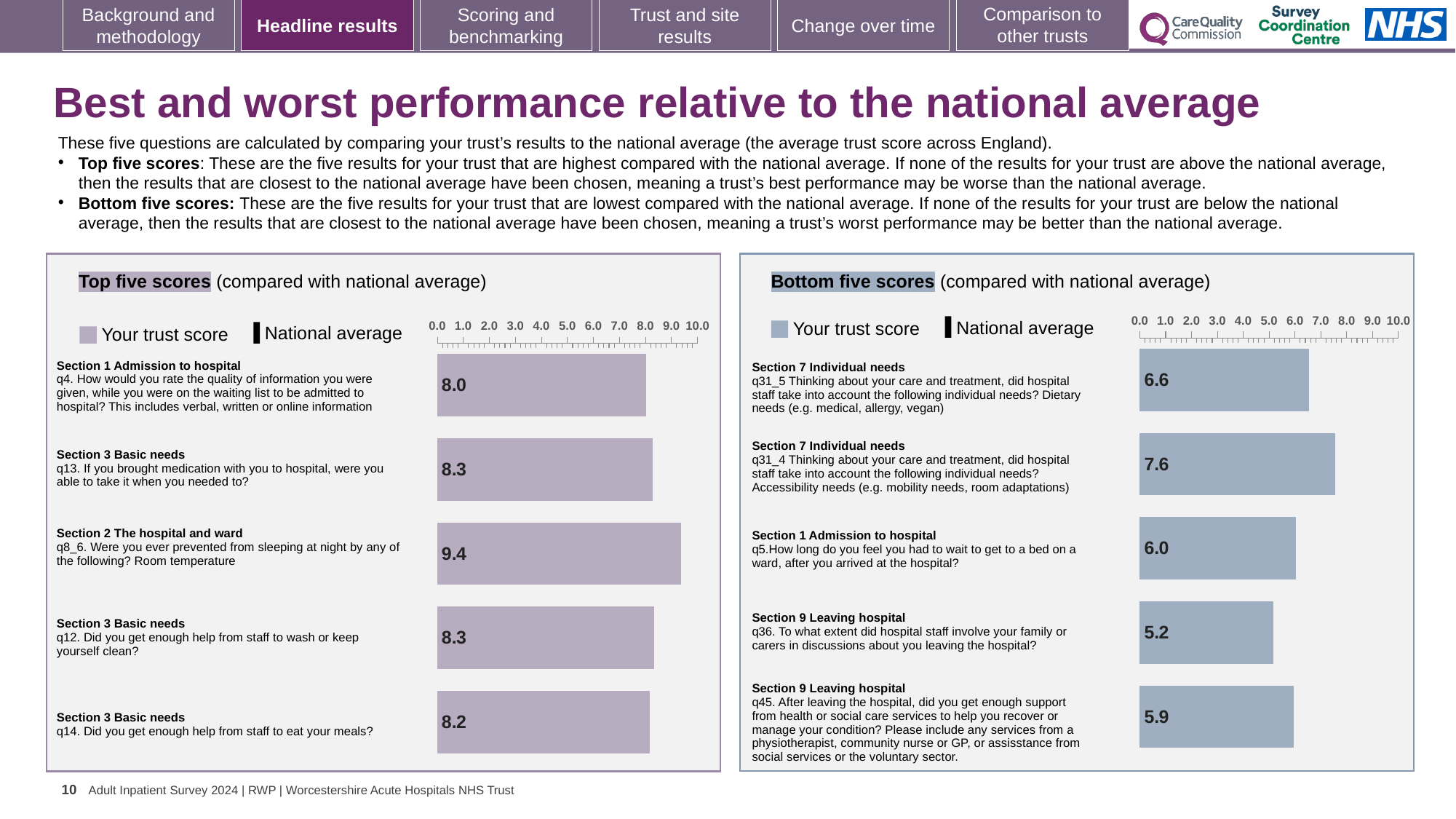
What type of chart is the Top five scores chart? Bar chart In the Bottom five scores chart, what is the trust score for q36 (staff involving family or carers in discussions about leaving hospital)? 5.2 How many questions are plotted in the Bottom five scores chart? 5 In the Bottom five scores chart, what is the difference between the trust scores for q31_4 and q36? 2.4 In the Bottom five scores chart, which has the larger trust score, q31_5 or q5? q31_5 In the Top five scores chart, what is the difference between the trust scores for q8_6 and q14? 1.2 How many entries does the legend of the Top five scores chart list? 2 In the Bottom five scores chart, what is the trust score for q31_4 (accessibility needs)? 7.6 In the Top five scores chart, what is the trust score for q4 (quality of information given while on the waiting list)? 8.0 In the Bottom five scores chart, which question has the lowest trust score? q36 (involving family or carers in discussions about leaving hospital) In the Top five scores chart, which question has the highest trust score? q8_6 (Room temperature) In the Top five scores chart, what is the trust score for q8_6 (prevented from sleeping at night by room temperature)? 9.4